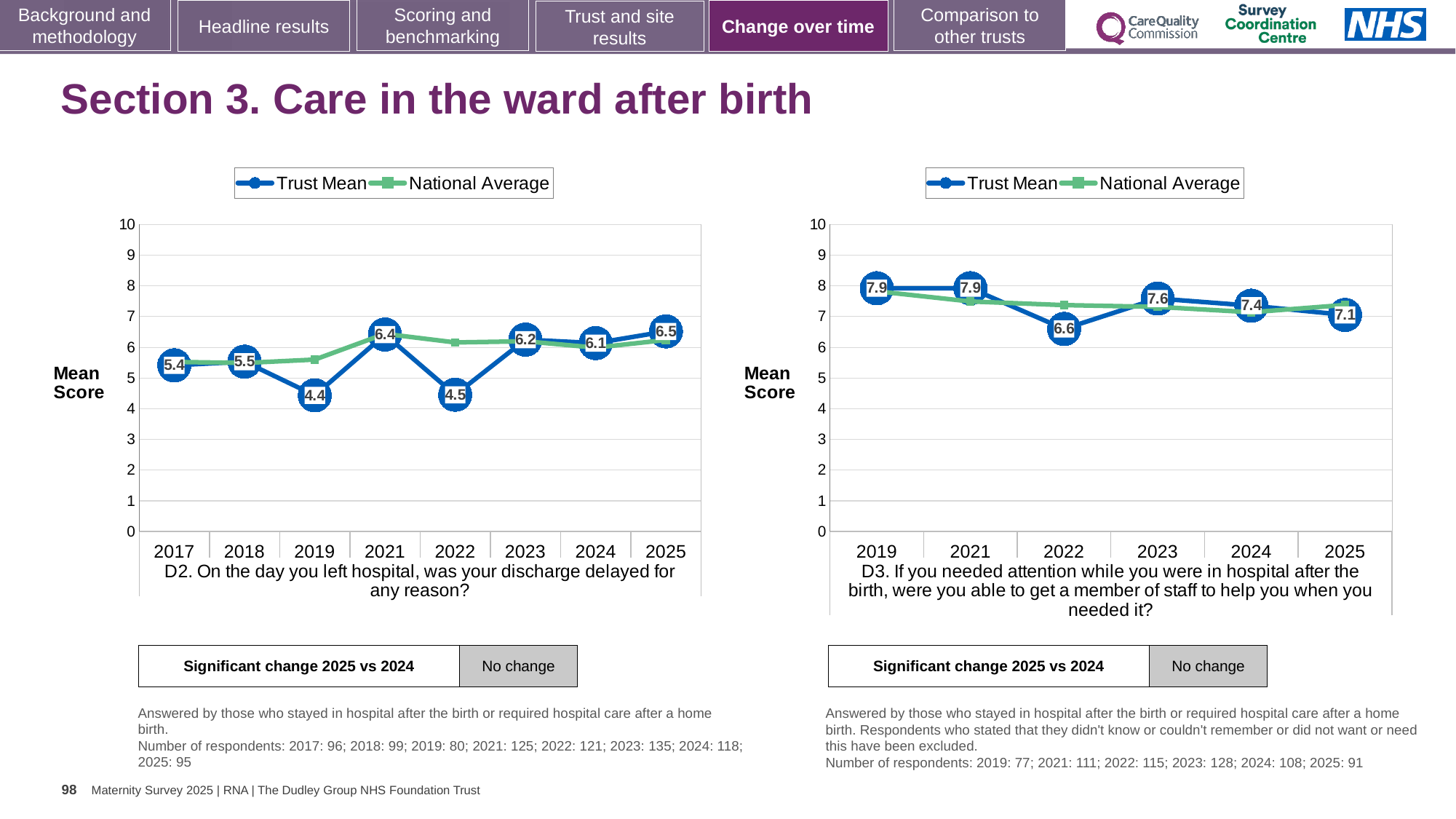
How many series does the legend of the D3 chart (right) list? 2 In the D2 chart (left), what is the Trust Mean score for 2019? 4.4 In the D3 chart (right), what is the Trust Mean score for 2022? 6.6 In the D3 chart (right), which year has the lowest Trust Mean score? 2022 In the D2 chart (left), what is the difference between the Trust Mean scores for 2021 and 2022? 1.9 In the D2 chart (left), how many years are plotted on the x axis? 8 In the D3 chart (right), is the Trust Mean score for 2023 or 2025 larger? 2023 In the D2 chart (left), which year has the lowest Trust Mean score? 2019 In the D2 chart (left), what is the Trust Mean score for 2025? 6.5 In the D3 chart (right), does the Trust Mean rise or fall from 2023 to 2025? fall In the D2 chart (left), which year has the highest Trust Mean score? 2025 In the D3 chart (right), is the National Average for 2019 greater or less than 7? greater